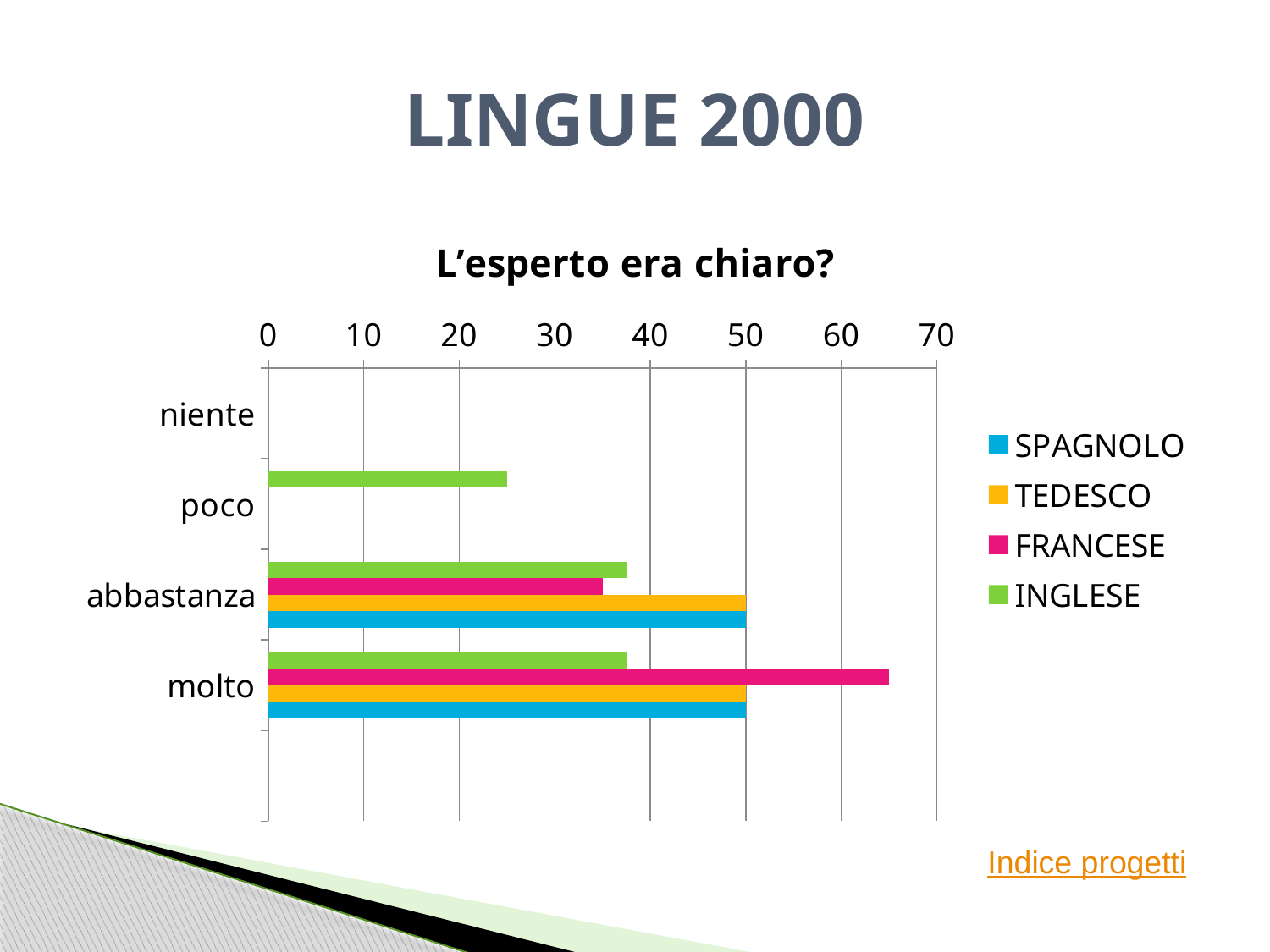
Which series is shown in green in the legend? INGLESE Which is larger in the 'molto' category: FRANCESE or INGLESE? FRANCESE Is the value for INGLESE in the 'poco' category greater or less than 30? less What is the value for SPAGNOLO in the 'molto' category? 50 What is the value for TEDESCO in the 'abbastanza' category? 50 Which series has the highest value in the 'molto' category? FRANCESE Is the value for FRANCESE in the 'molto' category greater or less than 60? greater What is the title of the chart? L'esperto era chiaro? How many categories are shown on the vertical axis? 4 What type of chart is shown on the slide? bar chart How many series does the legend list? 4 Is the value for FRANCESE in the 'abbastanza' category greater or less than 40? less